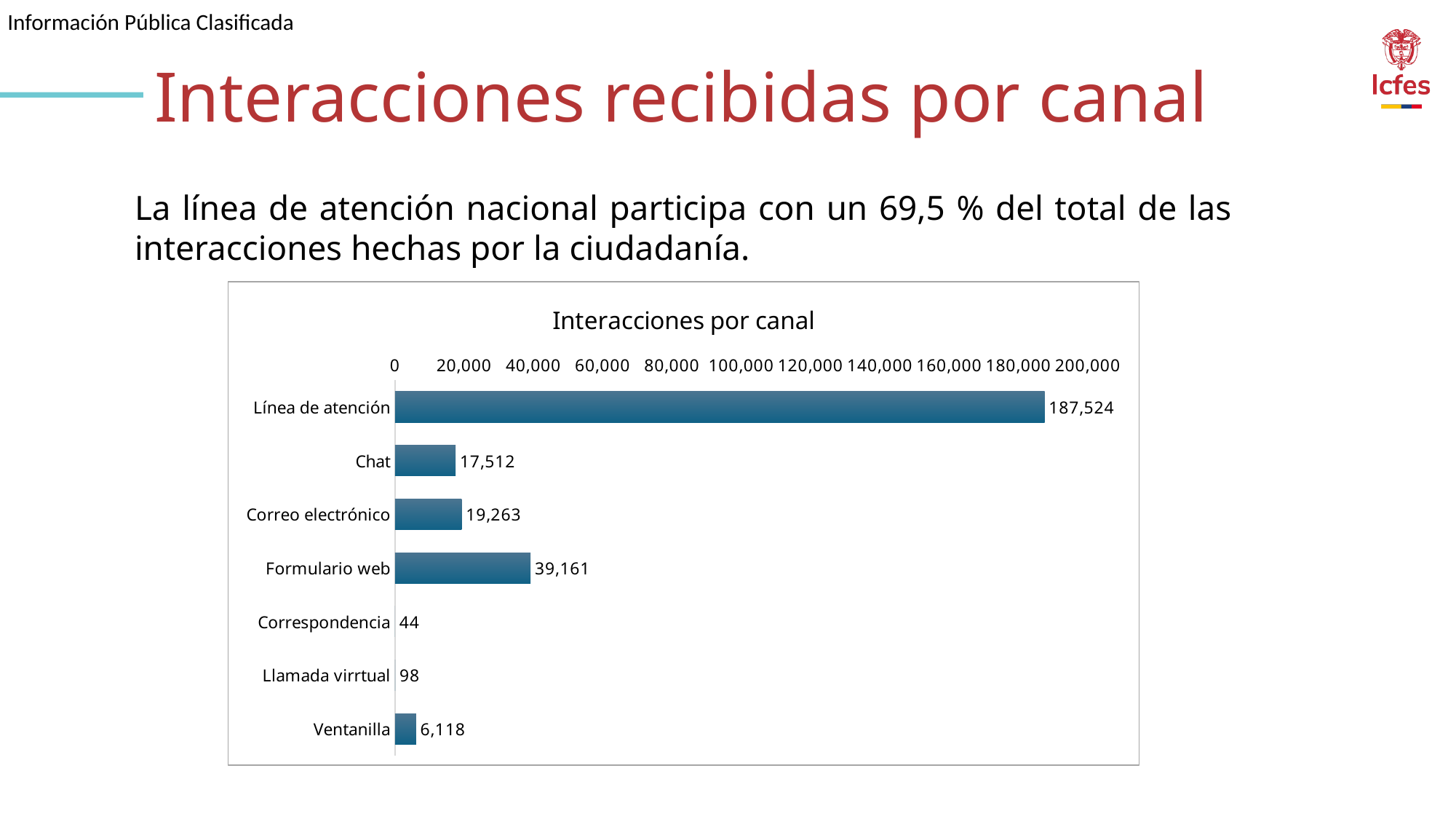
Which is larger, Formulario web or Correo electrónico? Formulario web Which channel has the lowest number of interactions? Correspondencia Which channel has the highest number of interactions? Línea de atención How many channels are shown in the chart? 7 What is the value for Formulario web? 39,161 What is the difference between Correo electrónico and Chat? 1,751 What is the title of the chart? Interacciones por canal What is the value for Correspondencia? 44 Is the value for Línea de atención greater or less than 180,000? greater What kind of chart is shown? Bar chart What is the value for Línea de atención? 187,524 What is the value for Ventanilla? 6,118